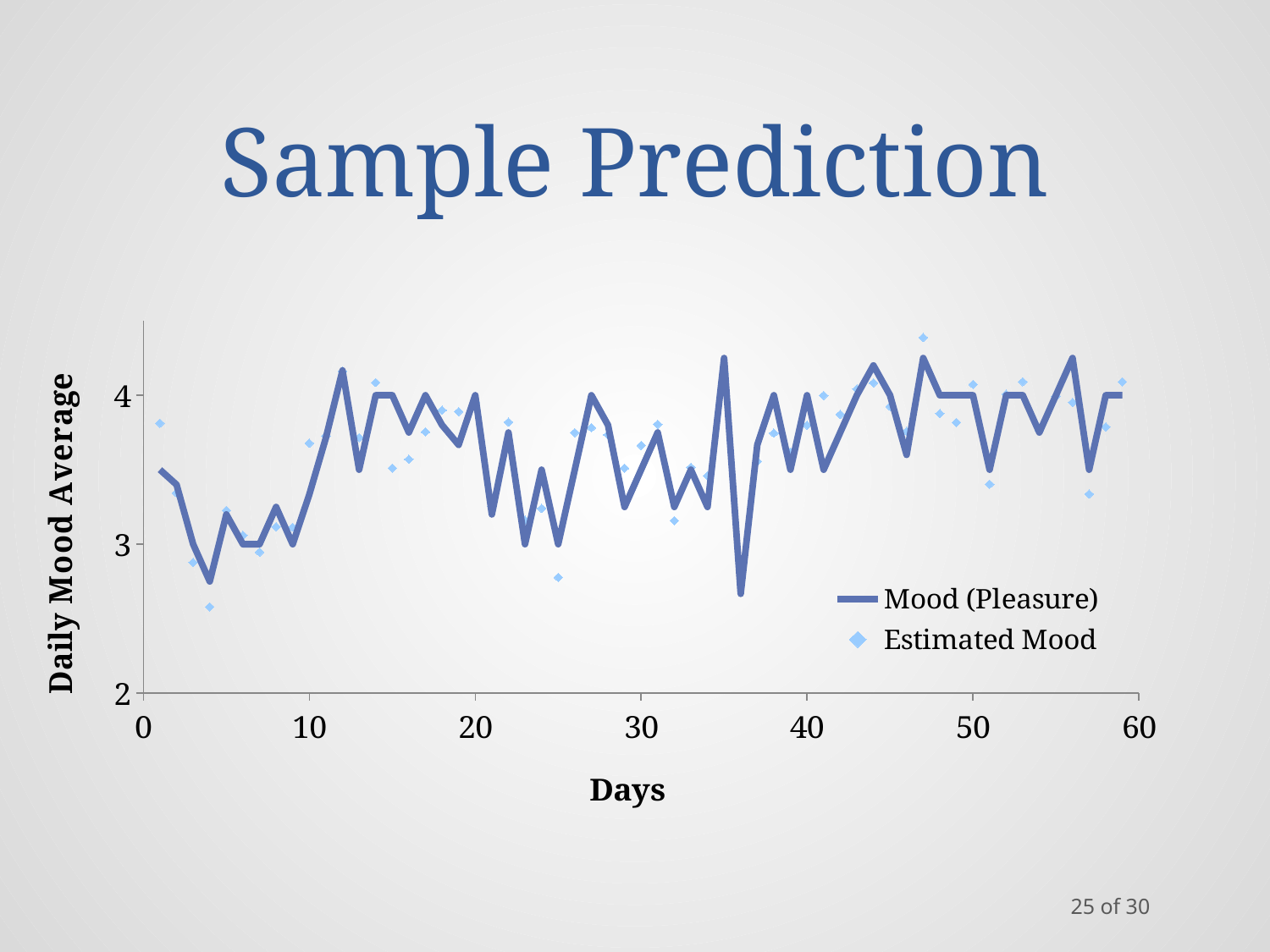
What is the label of the x axis? Days Is the Estimated Mood value at day 25 greater or less than 3? less How many series does the legend list? 2 Is the Mood (Pleasure) value at day 20 greater or less than 3? greater Is the Estimated Mood value at day 47 greater or less than 4? greater What kind of chart is shown on the slide? line chart What are the two series named in the legend? Mood (Pleasure) and Estimated Mood Do the Mood (Pleasure) values generally rise or fall from the first days to the last days on the x axis? rise